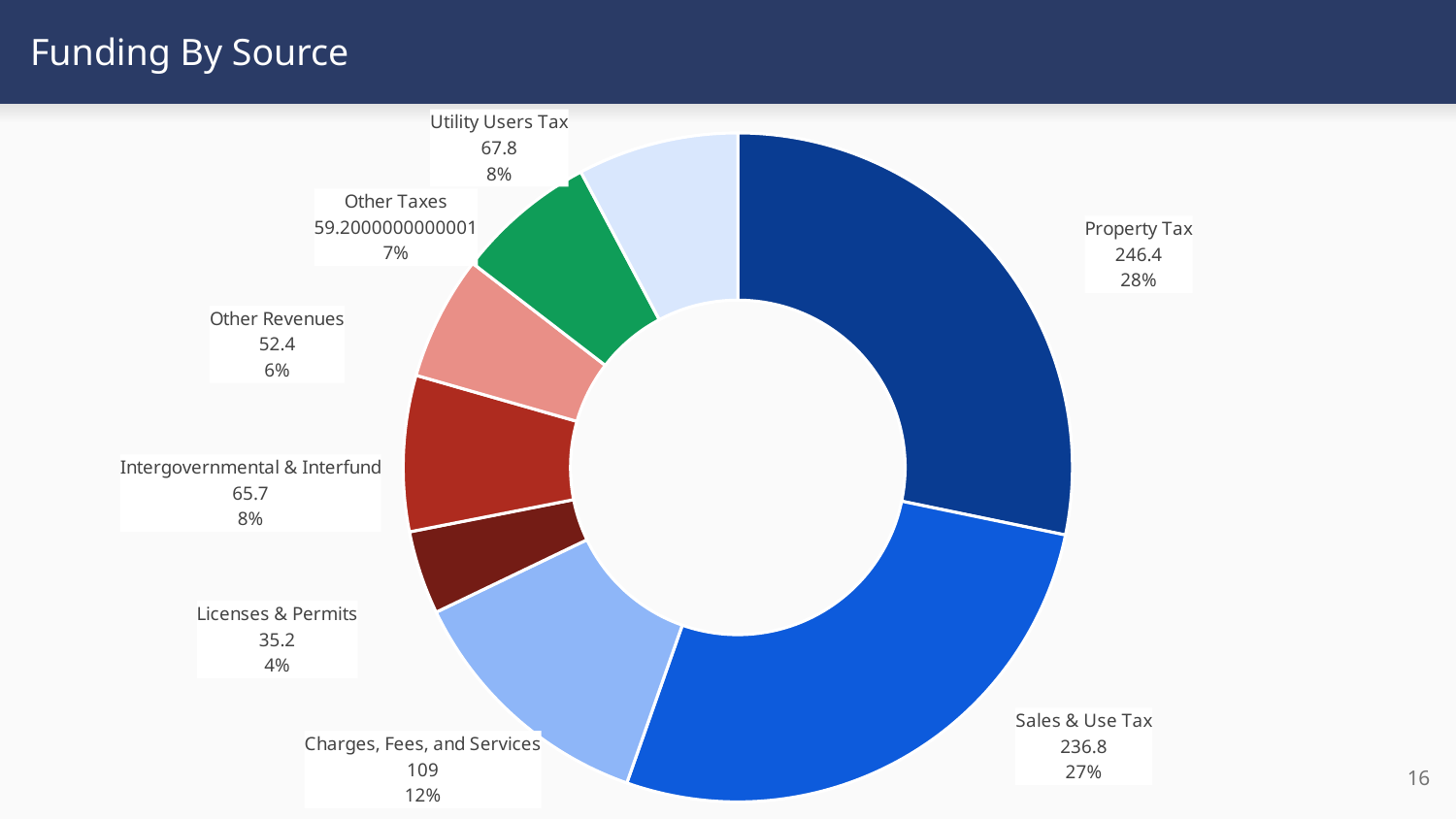
What type of chart is shown on the slide? Pie chart (donut) What is the value for Property Tax? 246.4 Which funding source has the largest share? Property Tax What is the difference between the values for Property Tax and Sales & Use Tax? 9.6 What is the value for Charges, Fees, and Services? 109 How many funding sources are shown in the chart? 8 What is the title of the slide? Funding By Source What share of the pie does Intergovernmental & Interfund represent? 8% What share of the pie does Sales & Use Tax represent? 27% What is the value for Licenses & Permits? 35.2 Which is larger, Utility Users Tax or Other Revenues? Utility Users Tax Which funding source has the smallest share? Licenses & Permits